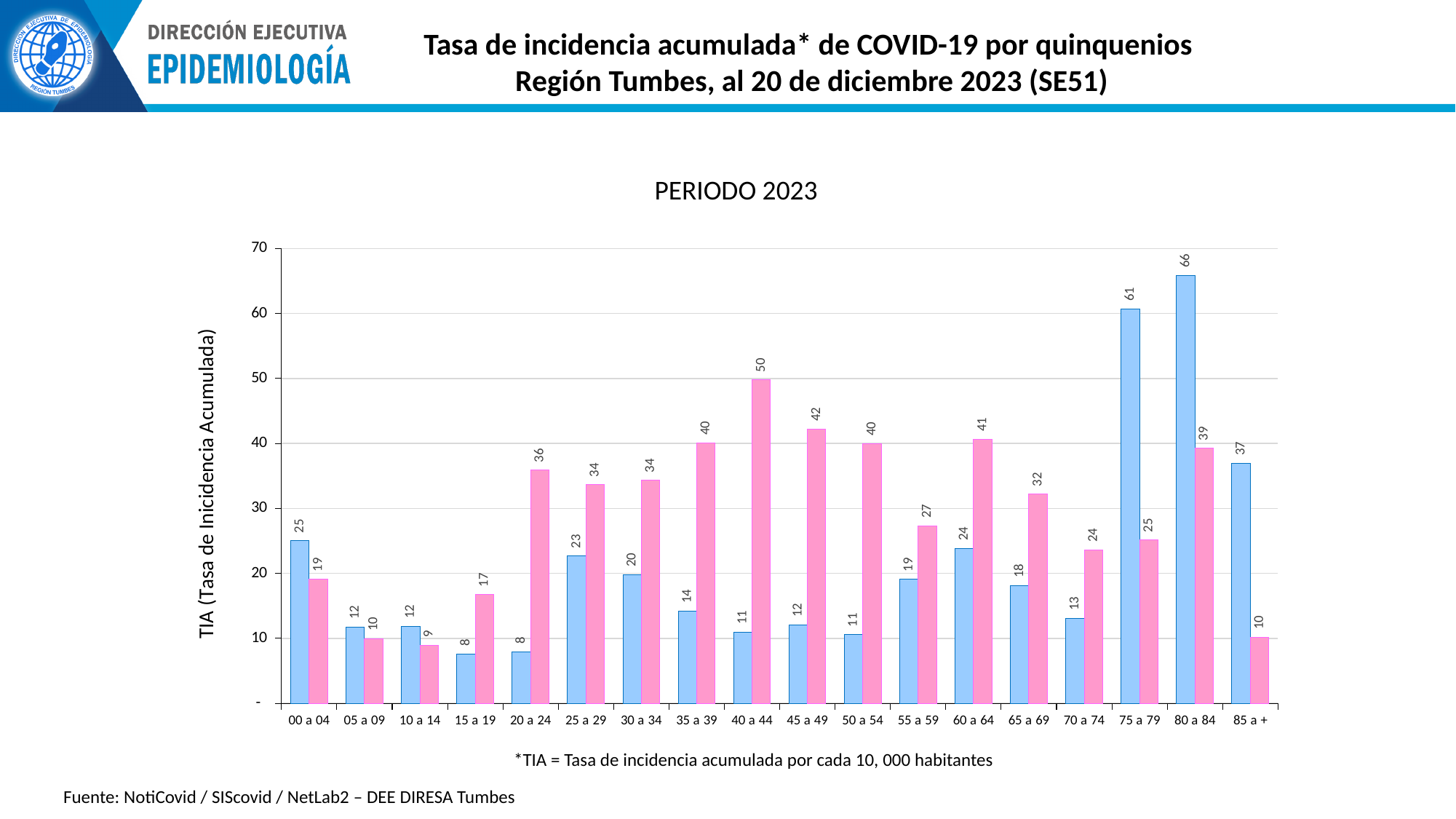
Which age group has the highest pink bar? 40 a 44 What is the label of the y axis? TIA (Tasa de Incidencia Acumulada) What is the value of the blue bar for the 85 a + age group? 37 What is the value of the pink bar for the 40 a 44 age group? 50 What is the value of the blue bar for the 80 a 84 age group? 66 What is the difference between the blue bar and the pink bar for the 75 a 79 age group? 36 For the 20 a 24 age group, which bar is larger, the blue or the pink? pink What is the title shown above the chart? PERIODO 2023 Which age group has the highest blue bar? 80 a 84 How many age-group categories are shown on the x axis? 18 Which age group has the lowest pink bar? 10 a 14 What type of chart is shown on the slide? bar chart